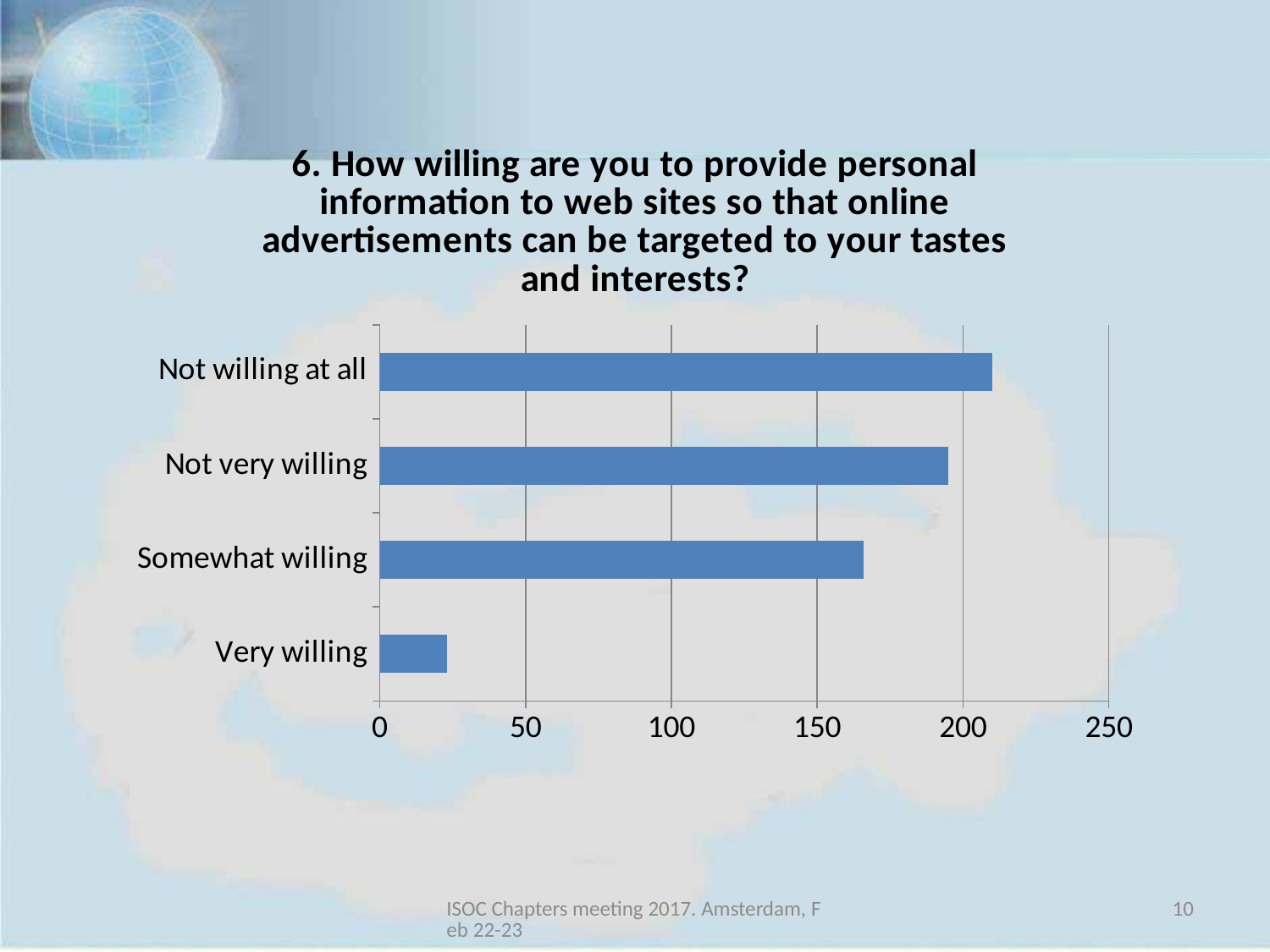
How many categories are shown in the chart? 4 Which category has the highest value? Not willing at all Do the bar values rise or fall going from the top category (Not willing at all) to the bottom category (Very willing)? fall Is the value for Not very willing greater or less than 200? less Is the value for Somewhat willing greater or less than 150? greater What kind of chart is shown on the slide? bar chart Is the value for Not willing at all greater or less than 200? greater Which category has the lowest value? Very willing What is the highest value shown on the horizontal axis of the chart? 250 Which is larger, the value for Somewhat willing or the value for Very willing? Somewhat willing